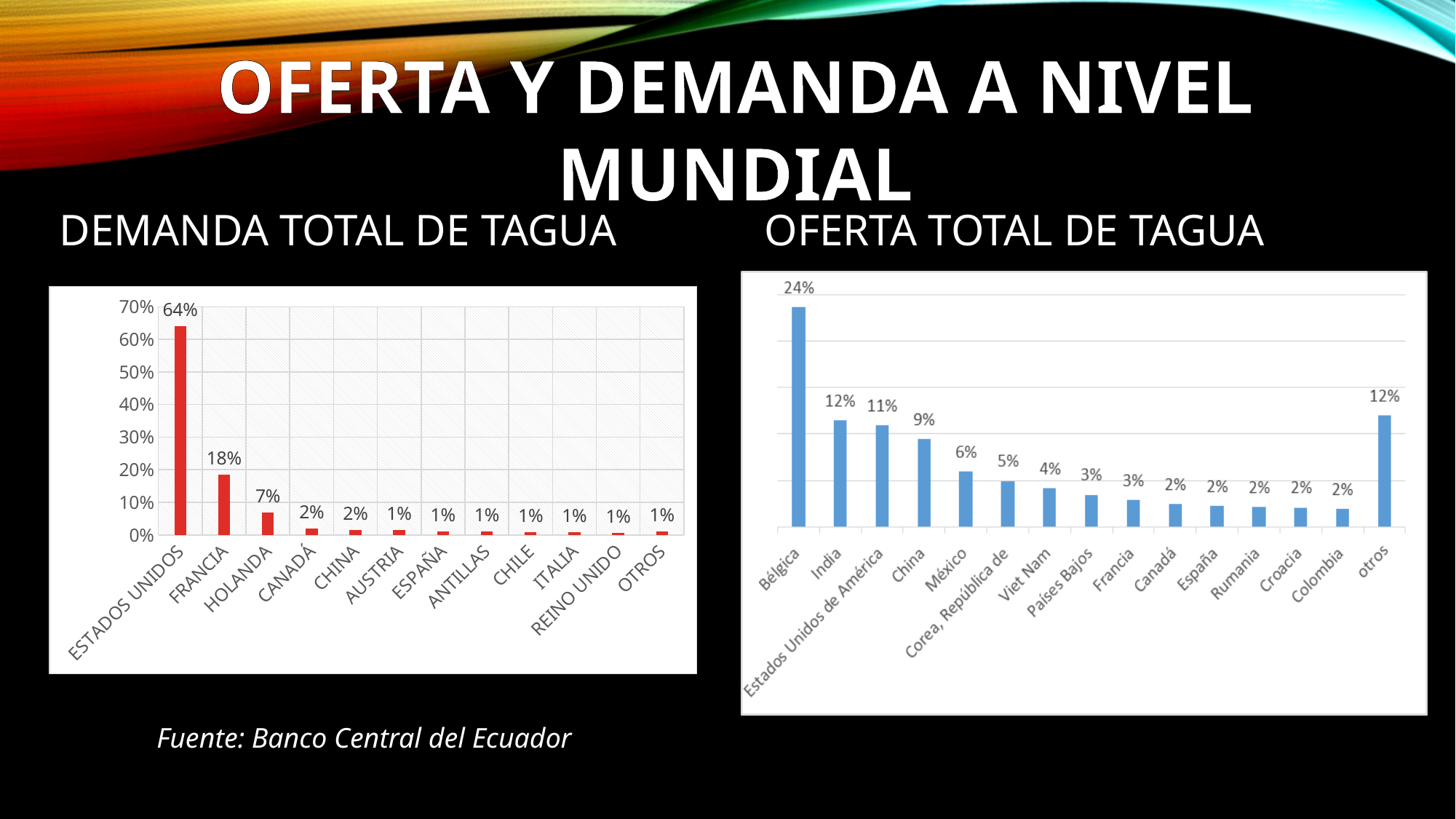
In the OFERTA TOTAL DE TAGUA chart, how many categories are shown on the x axis? 15 In the OFERTA TOTAL DE TAGUA chart, which category has the highest value? Bélgica In the OFERTA TOTAL DE TAGUA chart, what is the value for Bélgica? 24% In the OFERTA TOTAL DE TAGUA chart, what is the value for México? 6% What kind of chart is the DEMANDA TOTAL DE TAGUA chart? Bar chart In the OFERTA TOTAL DE TAGUA chart, what is the difference between Bélgica and Estados Unidos de América? 13% In the DEMANDA TOTAL DE TAGUA chart, how many categories are shown on the x axis? 12 In the DEMANDA TOTAL DE TAGUA chart, what is the value for FRANCIA? 18% In the DEMANDA TOTAL DE TAGUA chart, what is the value for ESTADOS UNIDOS? 64% In the DEMANDA TOTAL DE TAGUA chart, what is the difference between ESTADOS UNIDOS and FRANCIA? 46% In the DEMANDA TOTAL DE TAGUA chart, which category has the highest value? ESTADOS UNIDOS In the OFERTA TOTAL DE TAGUA chart, which is larger, India or China? India